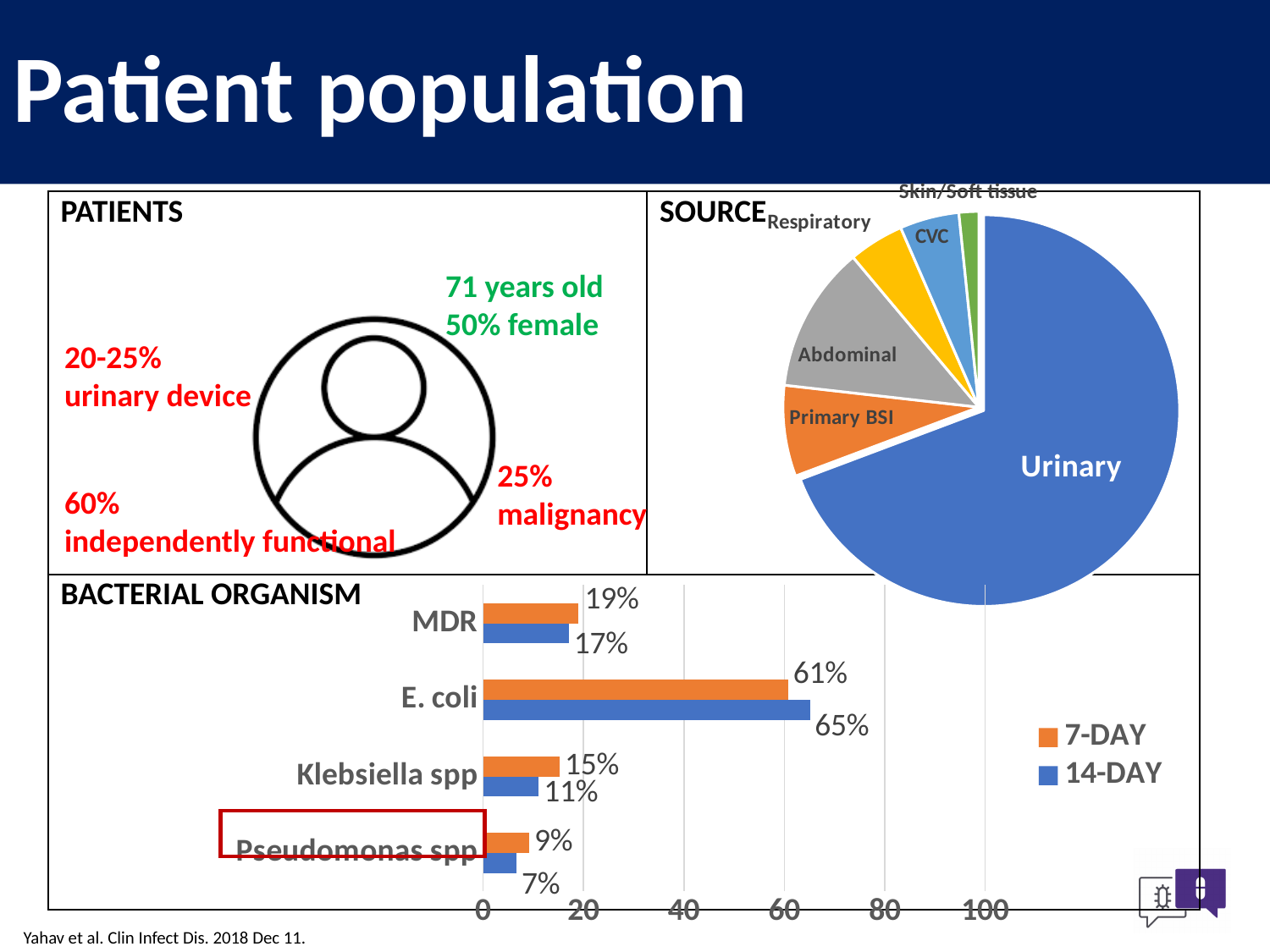
In the BACTERIAL ORGANISM bar chart, which is larger for MDR: the 7-DAY value or the 14-DAY value? 7-DAY In the BACTERIAL ORGANISM bar chart, which organism has the highest 14-DAY value? E. coli In the BACTERIAL ORGANISM bar chart, how many organism categories are shown? 4 In the BACTERIAL ORGANISM bar chart, what is the difference between the 14-DAY and 7-DAY values for E. coli? 4% In the BACTERIAL ORGANISM bar chart, what is the 14-DAY value for Pseudomonas spp? 7% In the BACTERIAL ORGANISM bar chart, which category has the lowest 7-DAY value? Pseudomonas spp In the BACTERIAL ORGANISM bar chart, what is the 7-DAY value for E. coli? 61% In the SOURCE pie chart, how many source categories are labelled? 6 In the BACTERIAL ORGANISM bar chart, how many series does the legend list? 2 In the BACTERIAL ORGANISM bar chart, what is the 14-DAY value for Klebsiella spp? 11% In the SOURCE pie chart, which source has the largest slice? Urinary What kind of chart is the BACTERIAL ORGANISM chart? Bar chart